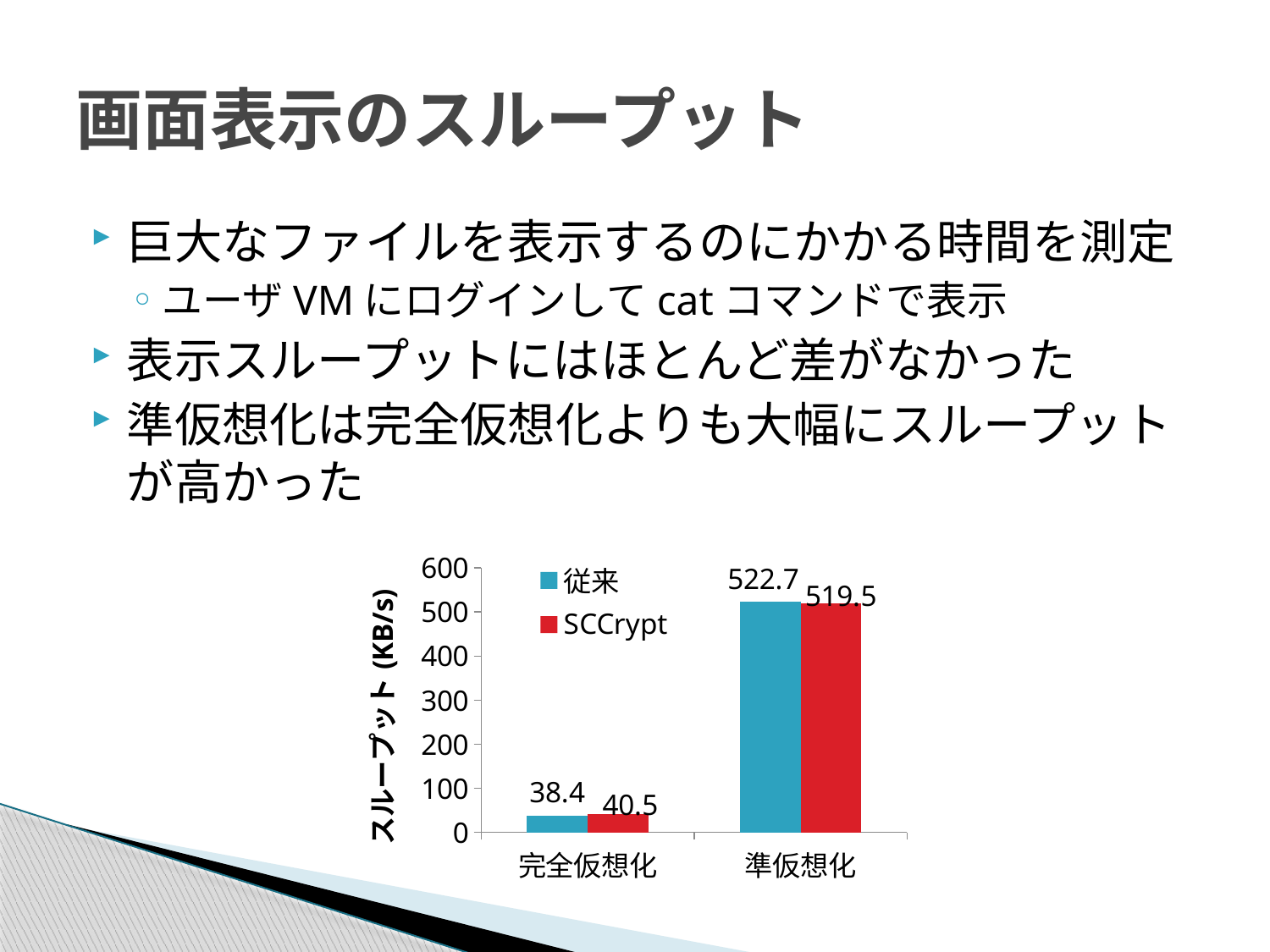
What is the value for SCCrypt in the 完全仮想化 category? 40.5 What is the value for 従来 in the 準仮想化 category? 522.7 Which category has the highest value for 従来? 準仮想化 Which category has the lowest value for SCCrypt? 完全仮想化 Is the SCCrypt value for 準仮想化 greater or less than 500? greater What is the difference between the 従来 and SCCrypt values in the 準仮想化 category? 3.2 How many categories are shown on the x axis? 2 What is the value for 従来 in the 完全仮想化 category? 38.4 What is the value for SCCrypt in the 準仮想化 category? 519.5 What is the difference between the 従来 values for 準仮想化 and 完全仮想化? 484.3 How many series does the legend list? 2 What kind of chart is shown on the slide? bar chart